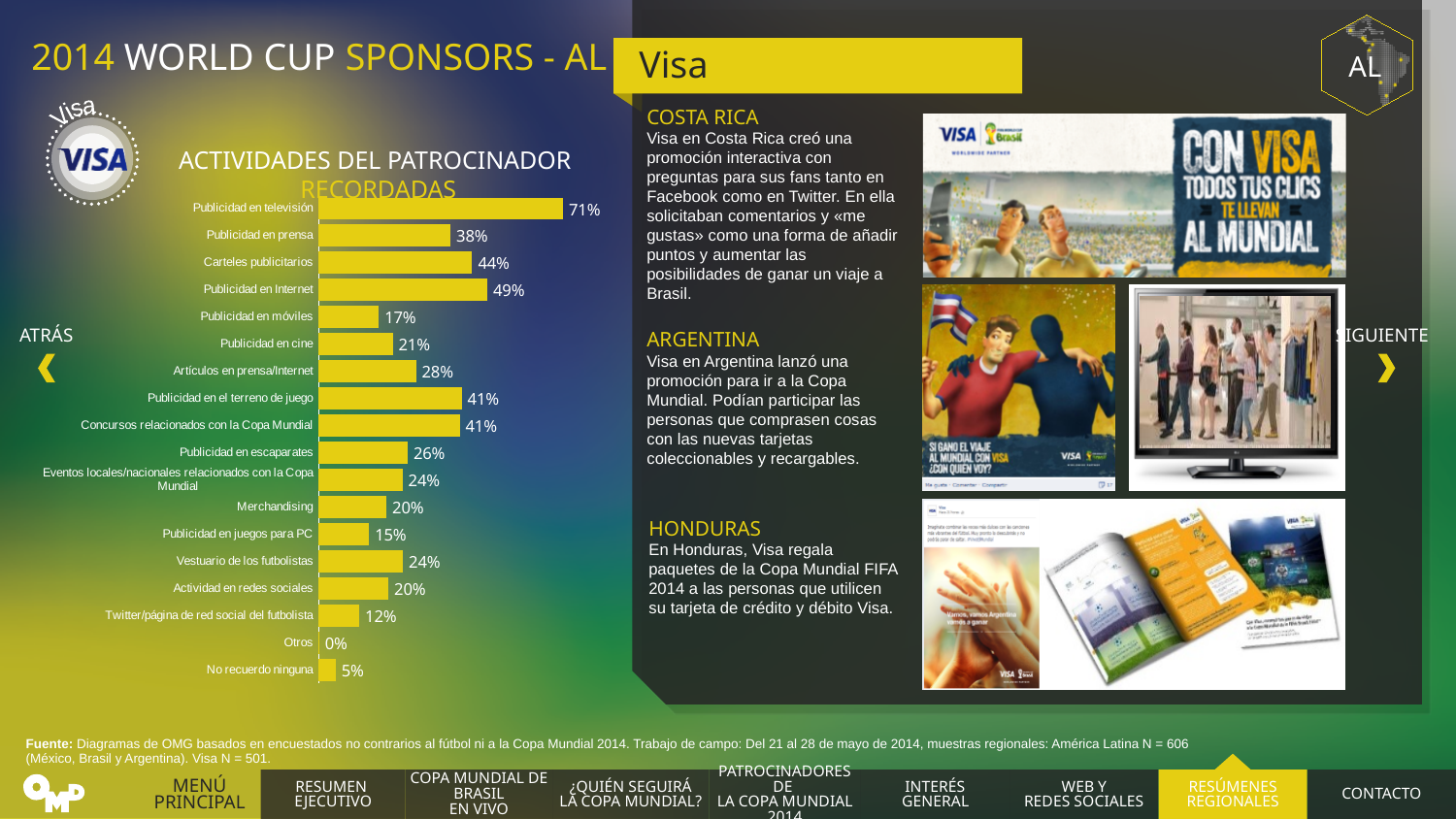
What value is shown for No recuerdo ninguna? 5% What is the difference between Carteles publicitarios and Publicidad en móviles? 27% Which is larger, Publicidad en cine or Publicidad en escaparates? Publicidad en escaparates Which is larger, Publicidad en Internet or Carteles publicitarios? Publicidad en Internet What is the difference between Publicidad en televisión and Publicidad en prensa? 33% What value is shown for Publicidad en Internet? 49% What value is shown for Twitter/página de red social del futbolista? 12% Which category has the highest value? Publicidad en televisión What type of chart is shown on the slide? Bar chart What value is shown for Publicidad en televisión? 71% How many categories are shown in the chart? 18 Which category has the lowest value? Otros